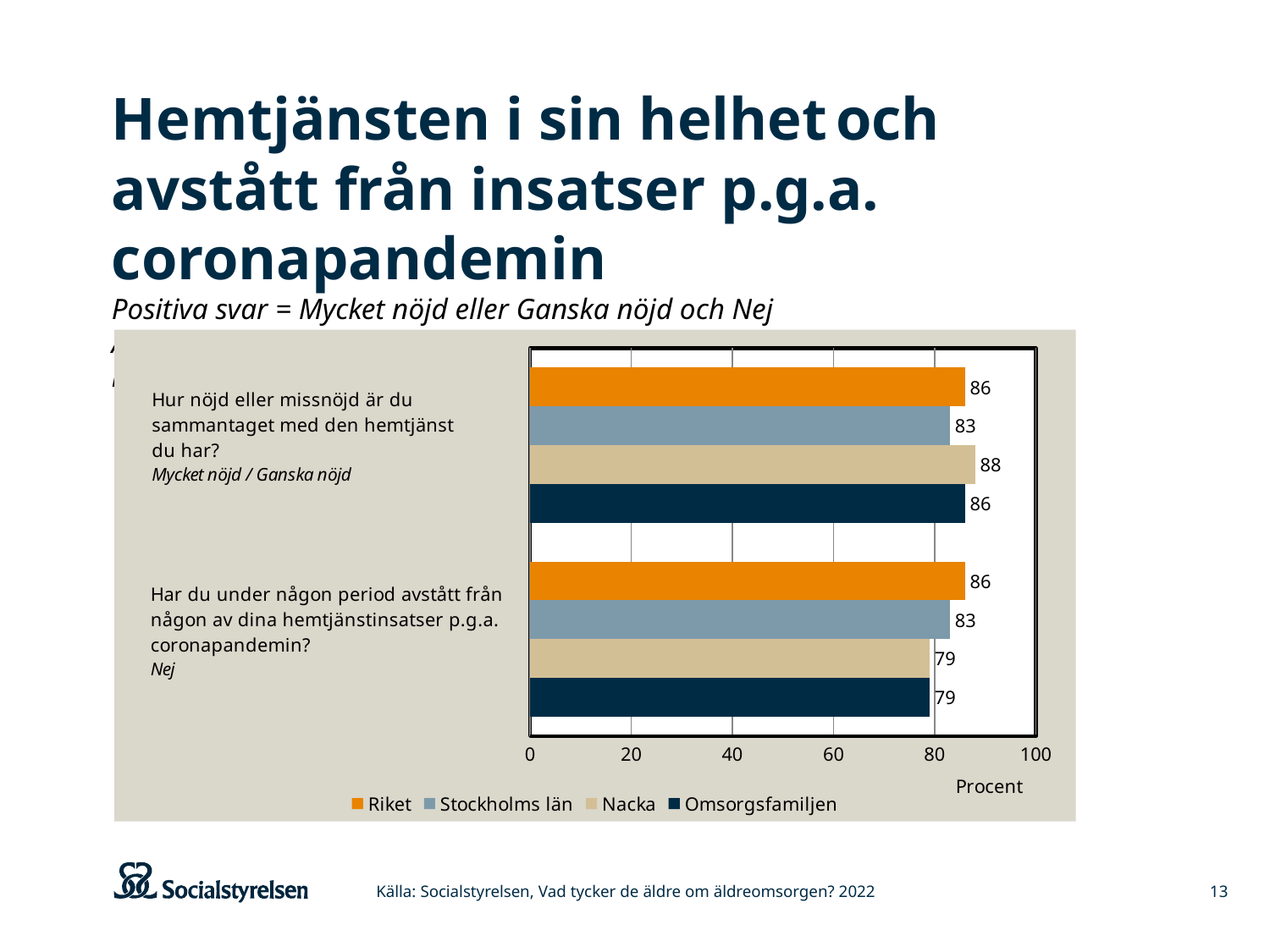
Which series has the highest value on the question "Har du under någon period avstått från någon av dina hemtjänstinsatser p.g.a. coronapandemin?"? Riket What is the value for Stockholms län on the question "Har du under någon period avstått från någon av dina hemtjänstinsatser p.g.a. coronapandemin?"? 83 Is the value for Nacka on the question "Har du under någon period avstått från någon av dina hemtjänstinsatser p.g.a. coronapandemin?" greater or less than 80? less How many series does the legend list? 4 What is the value for Omsorgsfamiljen on the question "Har du under någon period avstått från någon av dina hemtjänstinsatser p.g.a. coronapandemin?"? 79 What is the difference between Riket and Nacka on the question "Har du under någon period avstått från någon av dina hemtjänstinsatser p.g.a. coronapandemin?"? 7 Which series has the highest value on the question "Hur nöjd eller missnöjd är du sammantaget med den hemtjänst du har?"? Nacka Which series has the lowest value on the question "Hur nöjd eller missnöjd är du sammantaget med den hemtjänst du har?"? Stockholms län What kind of chart is shown on the slide? Bar chart What is the difference between Nacka and Stockholms län on the question "Hur nöjd eller missnöjd är du sammantaget med den hemtjänst du har?"? 5 What is the label of the x axis? Procent What is the value for Nacka on the question "Hur nöjd eller missnöjd är du sammantaget med den hemtjänst du har?"? 88